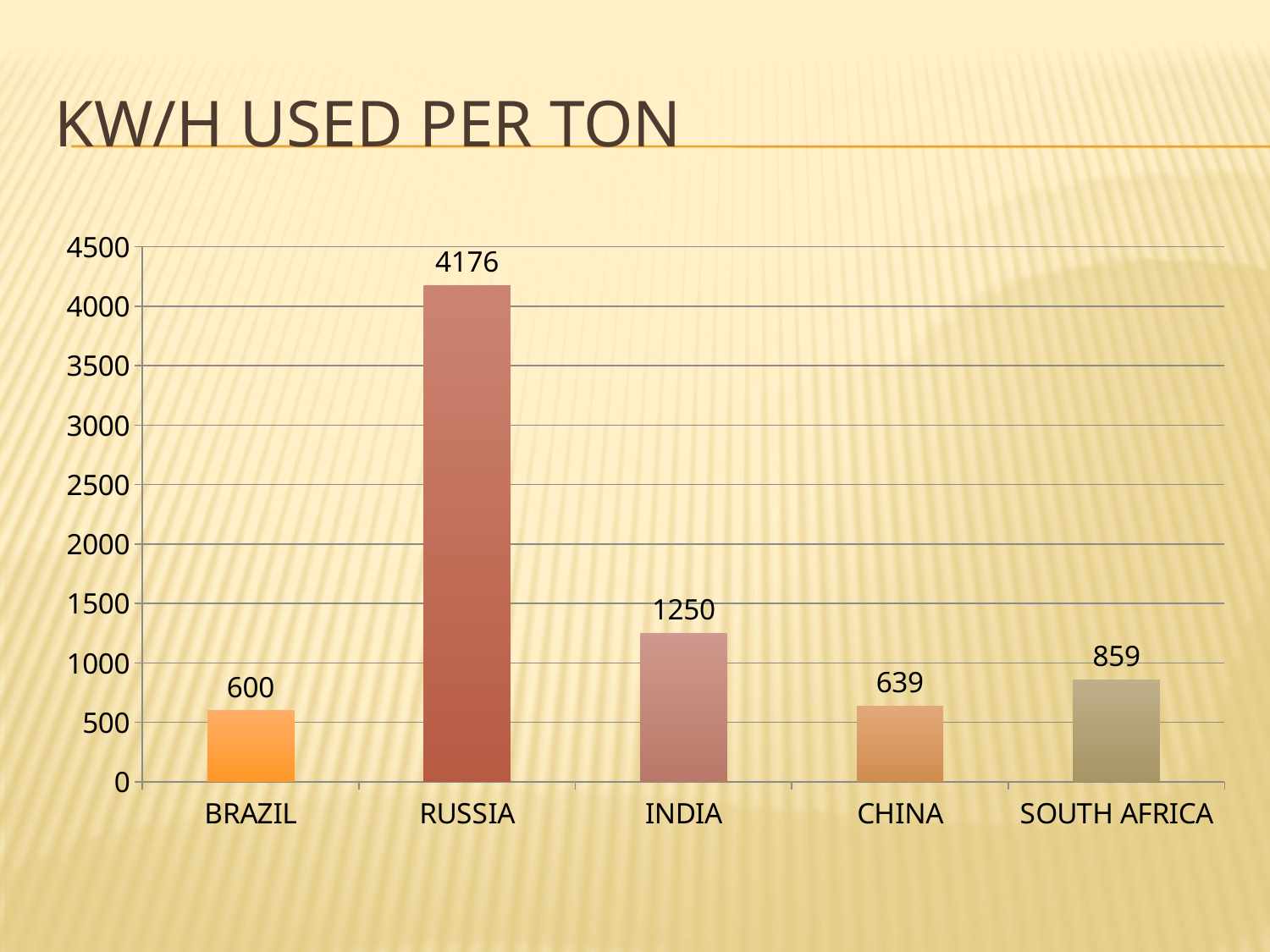
What is the value for South Africa? 859 What is the value for India? 1250 How many countries are shown on the chart? 5 Which is larger, the value for China or the value for Brazil? China What is the value for Russia? 4176 Which country has the highest value? Russia What is the title of the slide? KW/H USED PER TON What is the difference between the values for Russia and India? 2926 Is the value for India greater or less than 1000? greater Which country has the lowest value? Brazil What kind of chart is shown on the slide? Bar chart What is the difference between the values for South Africa and China? 220